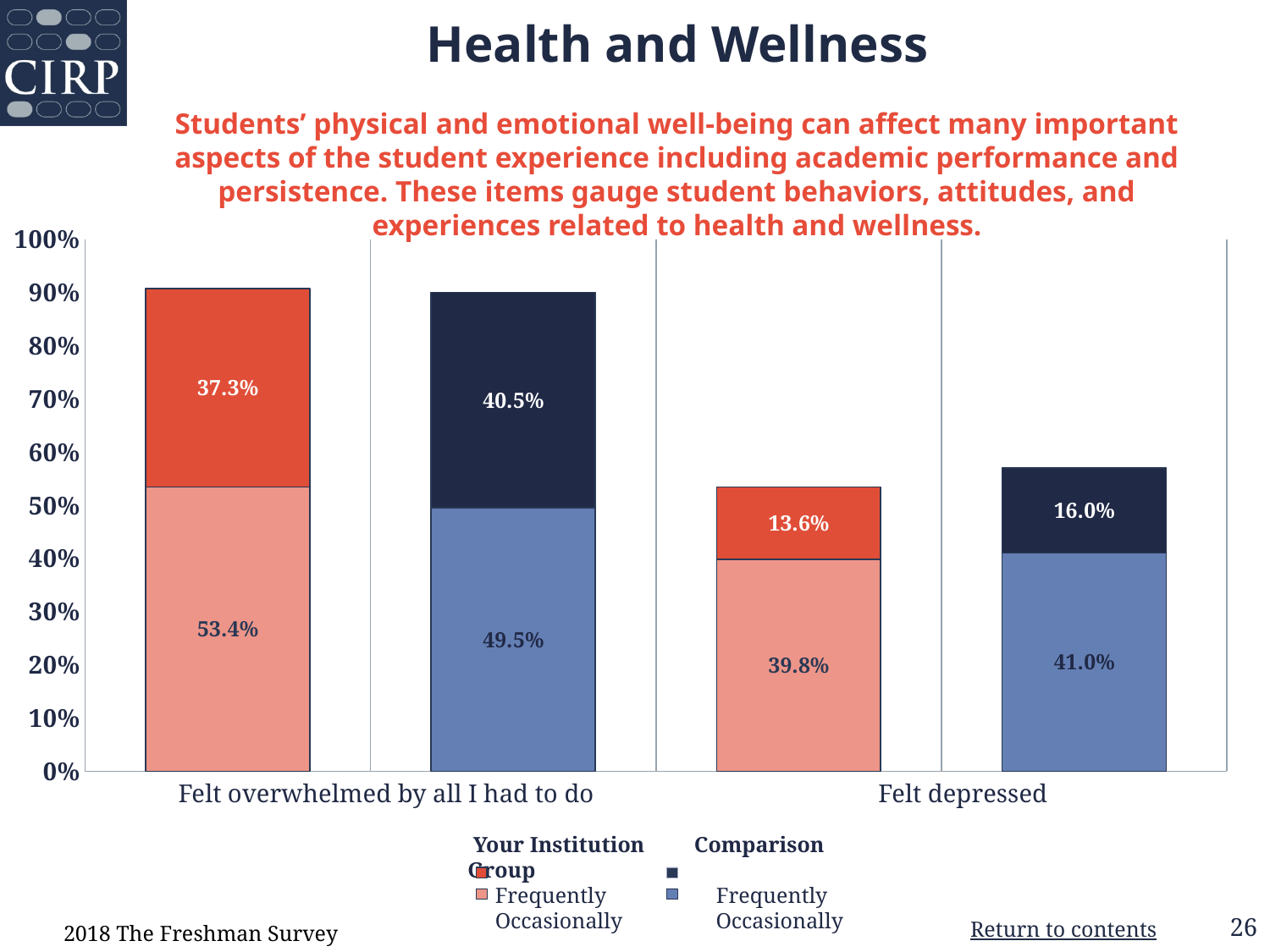
What percentage of students at Your Institution reported frequently feeling overwhelmed by all they had to do? 37.3% How many categories are shown on the x axis? 2 What kind of chart is shown on the slide? Stacked bar chart What is the difference between the Comparison Group and Your Institution for frequently feeling overwhelmed by all they had to do? 3.2% How many series does the legend list? 4 What is the total of the stacked bar for Your Institution under 'Felt depressed'? 53.4% What percentage of students at Your Institution reported occasionally feeling overwhelmed by all they had to do? 53.4% Which is larger for frequently feeling depressed: Your Institution or the Comparison Group? Comparison Group Which segment has the lowest value on the chart? Your Institution, Frequently, Felt depressed (13.6%) What percentage of students in the Comparison Group reported occasionally feeling depressed? 41.0% What is the total of the stacked bar for the Comparison Group under 'Felt overwhelmed by all I had to do'? 90.0% What percentage of students in the Comparison Group reported frequently feeling depressed? 16.0%